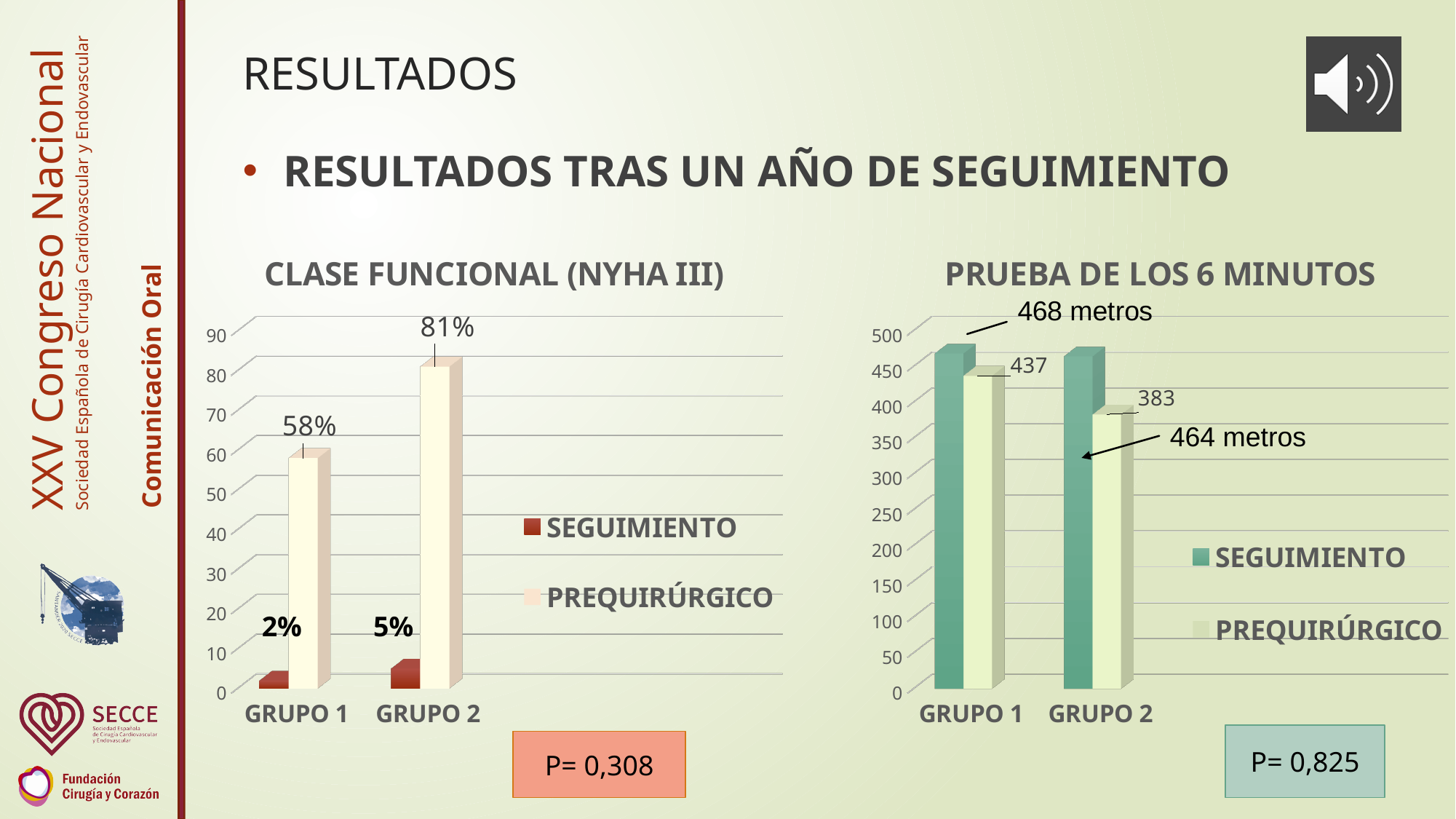
What kind of chart is the CLASE FUNCIONAL (NYHA III) chart? Bar chart In the CLASE FUNCIONAL (NYHA III) chart, what is the SEGUIMIENTO value for GRUPO 2? 5% In the PRUEBA DE LOS 6 MINUTOS chart, what is the SEGUIMIENTO value for GRUPO 1? 468 metros How many series does the legend of the PRUEBA DE LOS 6 MINUTOS chart list? 2 In the PRUEBA DE LOS 6 MINUTOS chart, is the SEGUIMIENTO value for GRUPO 2 greater or less than the PREQUIRÚRGICO value for GRUPO 2? greater In the PRUEBA DE LOS 6 MINUTOS chart, what is the PREQUIRÚRGICO value for GRUPO 2? 383 In the CLASE FUNCIONAL (NYHA III) chart, what is the SEGUIMIENTO value for GRUPO 1? 2% In the PRUEBA DE LOS 6 MINUTOS chart, what is the PREQUIRÚRGICO value for GRUPO 1? 437 In the CLASE FUNCIONAL (NYHA III) chart, what is the difference between the PREQUIRÚRGICO values for GRUPO 2 and GRUPO 1? 23% In the CLASE FUNCIONAL (NYHA III) chart, what is the PREQUIRÚRGICO value for GRUPO 2? 81% In the PRUEBA DE LOS 6 MINUTOS chart, which group has the lower PREQUIRÚRGICO value? GRUPO 2 In the CLASE FUNCIONAL (NYHA III) chart, which group has the higher PREQUIRÚRGICO value? GRUPO 2